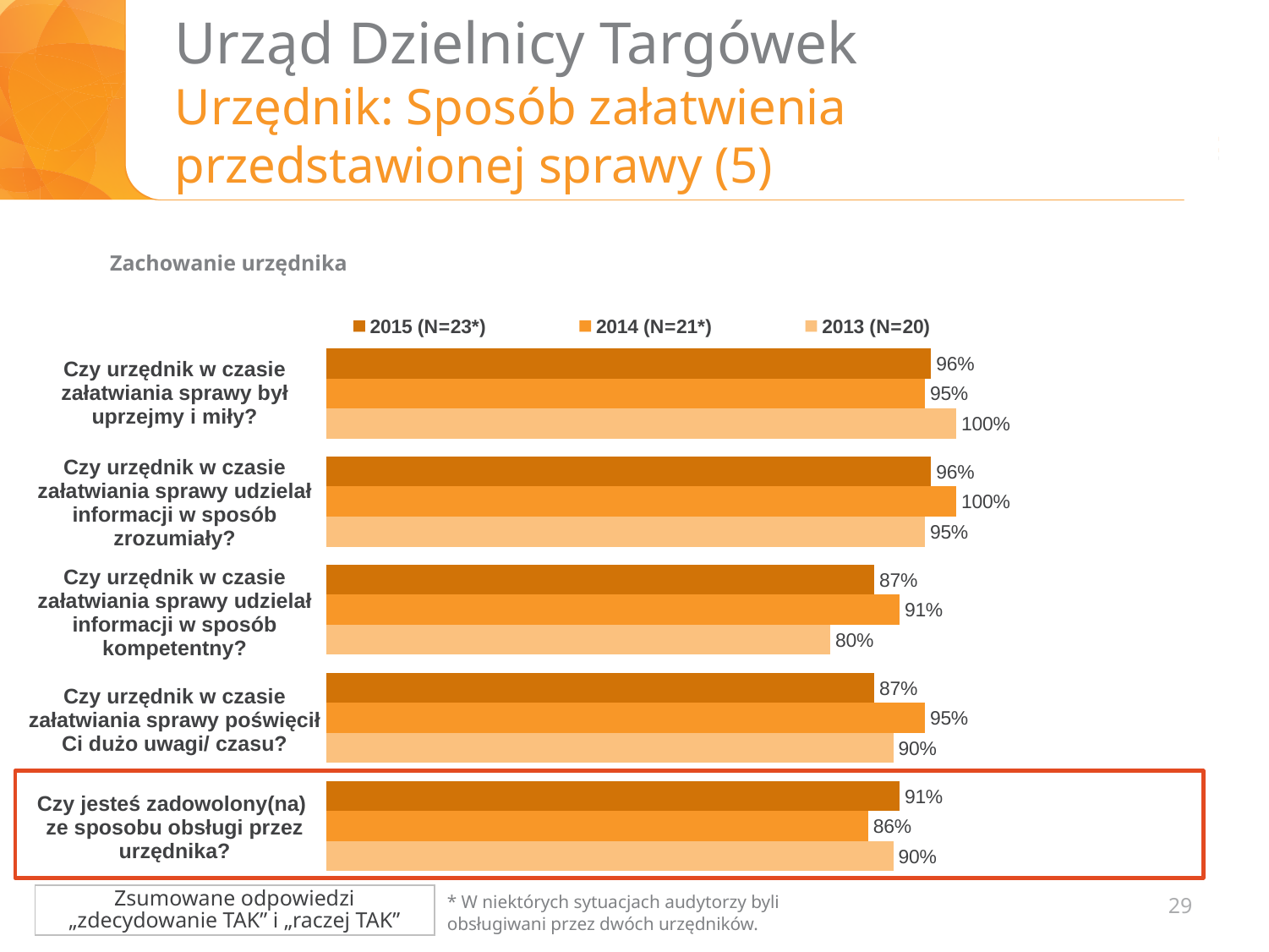
For "Czy jesteś zadowolony(na) ze sposobu obsługi przez urzędnika?", which year has the larger value, 2015 or 2013? 2015 What is the 2015 (N=23*) value for "Czy urzędnik w czasie załatwiania sprawy był uprzejmy i miły?"? 96% What is the 2013 (N=20) value for "Czy urzędnik w czasie załatwiania sprawy udzielał informacji w sposób kompetentny?"? 80% What is the 2014 (N=21*) value for "Czy urzędnik w czasie załatwiania sprawy poświęcił Ci dużo uwagi/ czasu?"? 95% Which question has the lowest 2015 (N=23*) value? Czy urzędnik w czasie załatwiania sprawy udzielał informacji w sposób kompetentny? and Czy urzędnik w czasie załatwiania sprawy poświęcił Ci dużo uwagi/ czasu? (both 87%) How many series does the legend list? 3 What is the title shown above the chart? Zachowanie urzędnika Which question has the highest 2014 (N=21*) value? Czy urzędnik w czasie załatwiania sprawy udzielał informacji w sposób zrozumiały? What is the difference between the 2014 and 2013 values for "Czy urzędnik w czasie załatwiania sprawy udzielał informacji w sposób kompetentny?"? 11 percentage points What type of chart is shown on the slide? Bar chart How many questions (categories) are shown in the chart? 5 What is the 2014 (N=21*) value for "Czy jesteś zadowolony(na) ze sposobu obsługi przez urzędnika?"? 86%